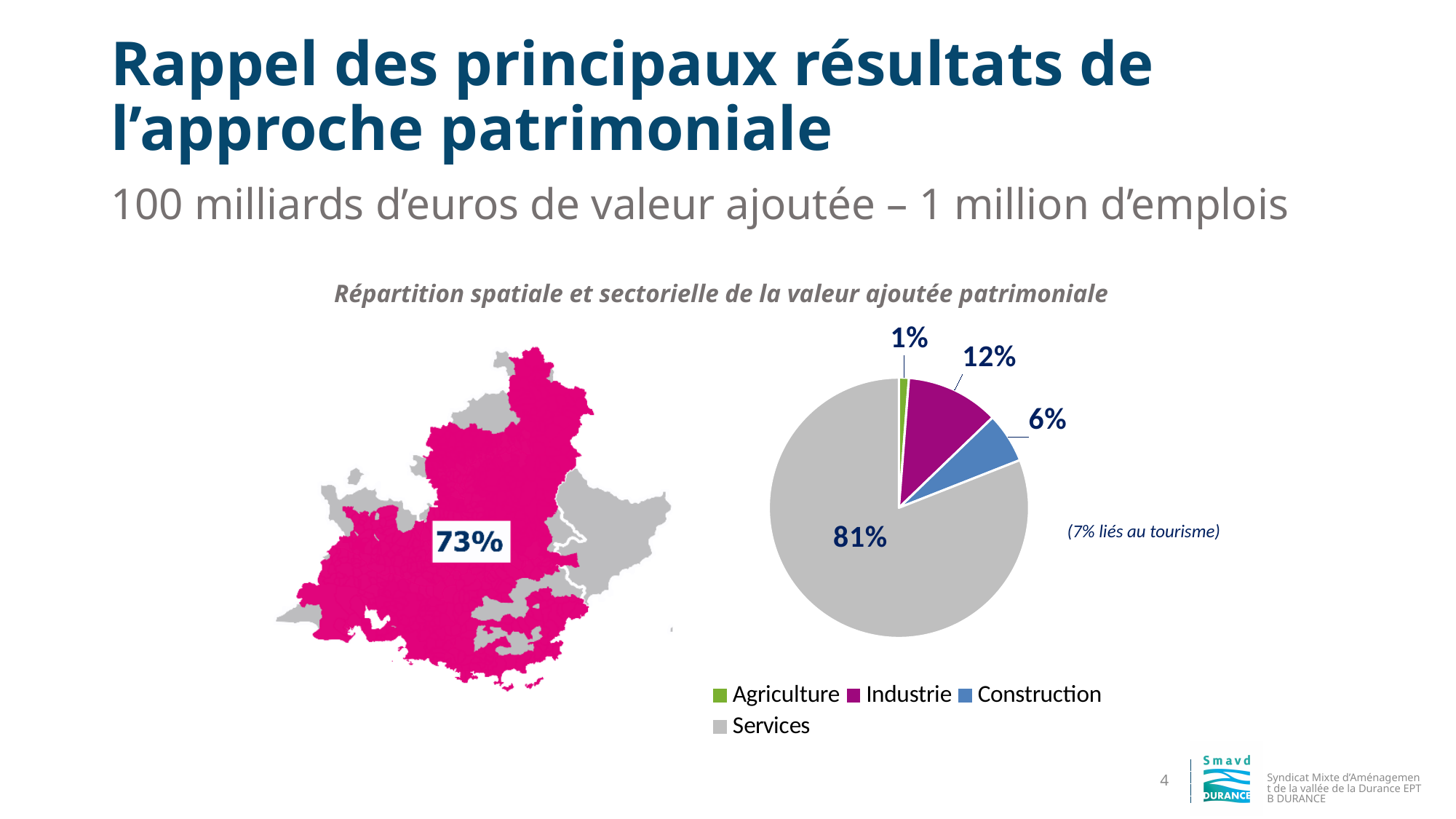
Which slice is larger in the pie chart, Industrie or Construction? Industrie How many sectors are shown in the pie chart? 4 What share of the pie chart does Construction represent? 6% What colour is the Industrie slice in the pie chart? purple What is the title of the chart on the slide? Répartition spatiale et sectorielle de la valeur ajoutée patrimoniale What share of the pie chart does Services represent? 81% Which sector has the smallest slice in the pie chart? Agriculture What type of chart is shown on the slide? pie chart What share of the pie chart does Agriculture represent? 1% Which sector has the largest slice in the pie chart? Services What is the difference in percentage points between the Industrie and Construction slices? 6 What share of the pie chart does Industrie represent? 12%